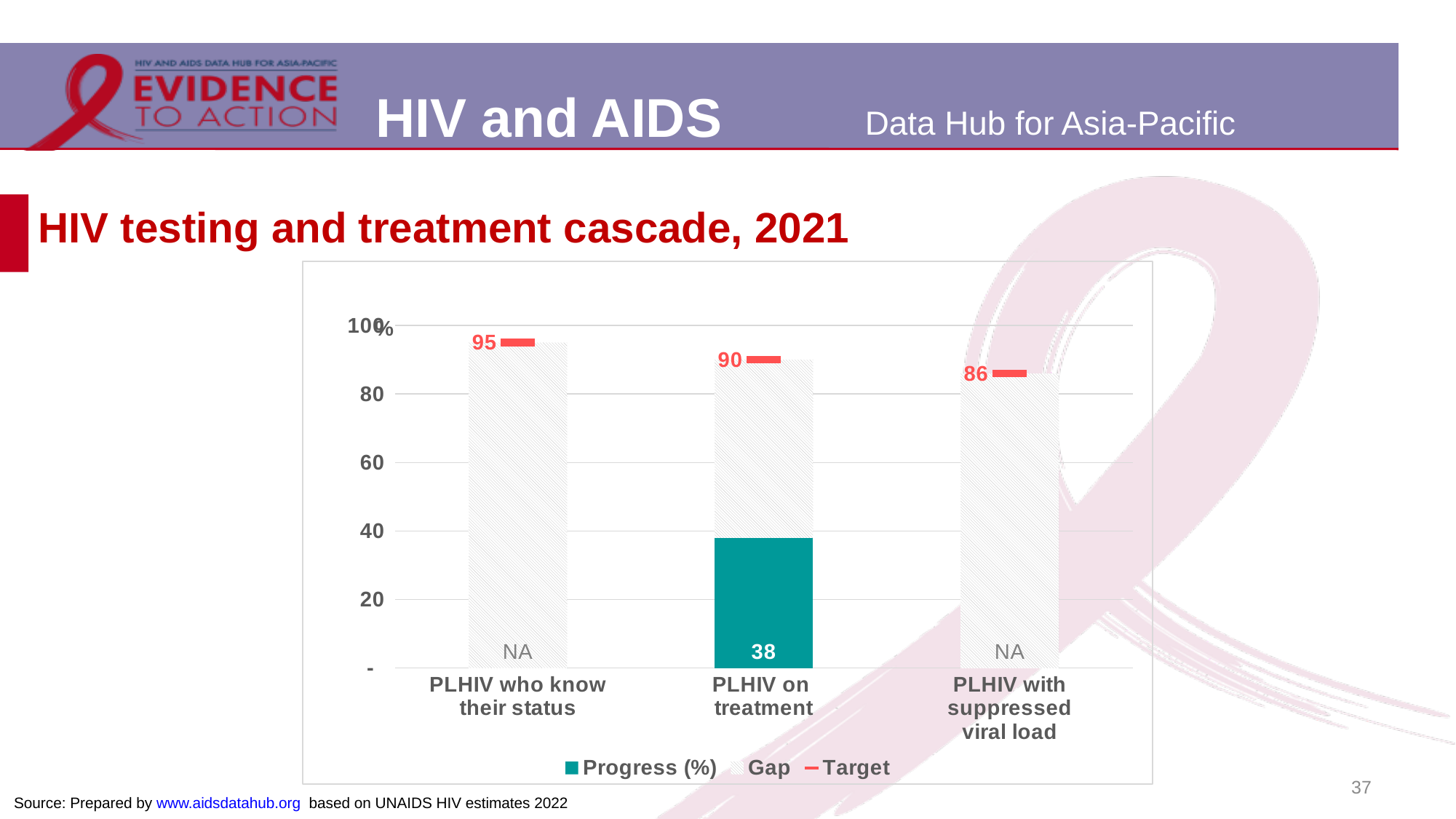
Is the Progress (%) value for PLHIV on treatment greater or less than 40? less Which category has the highest Target value? PLHIV who know their status Which category has the lowest Target value? PLHIV with suppressed viral load What is the difference between the Target and the Progress (%) value for PLHIV on treatment? 52 What kind of chart is shown on the slide? bar chart What is the Progress (%) value shown for PLHIV who know their status? NA How many categories are shown on the x axis? 3 What is the Target value for PLHIV with suppressed viral load? 86 What is the Progress (%) value for PLHIV on treatment? 38 What is the Target value for PLHIV who know their status? 95 How many series does the legend list? 3 What is the Target value for PLHIV on treatment? 90